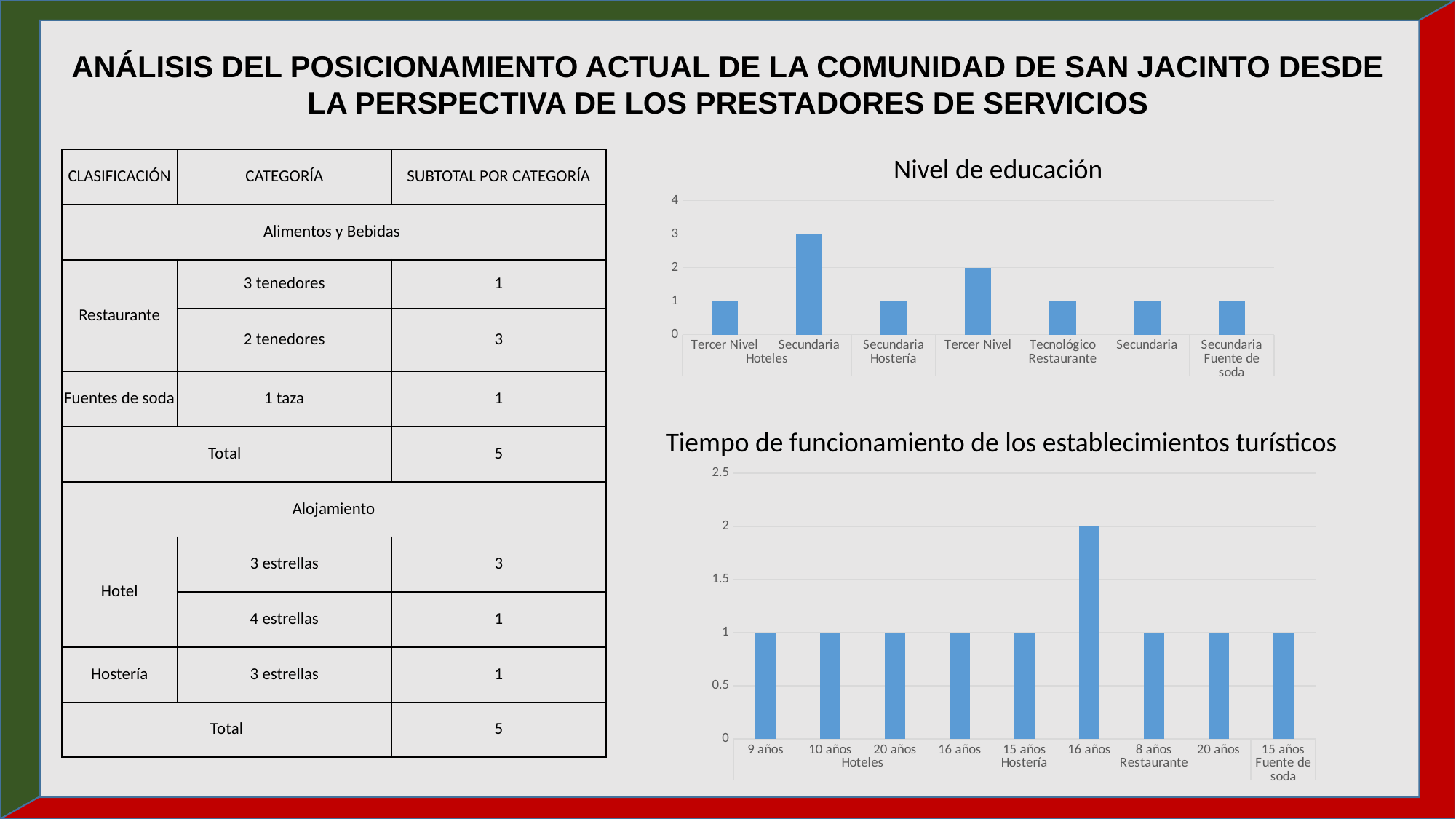
In the 'Nivel de educación' chart, which is larger: Secundaria under Hoteles or Secundaria under Hostería? Secundaria under Hoteles What kind of chart is 'Tiempo de funcionamiento de los establecimientos turísticos'? Bar chart In the 'Tiempo de funcionamiento de los establecimientos turísticos' chart, what is the value for 8 años under Restaurante? 1 In the 'Nivel de educación' chart, how many bars are plotted? 7 In the 'Nivel de educación' chart, what is the difference between Secundaria under Hoteles and Tercer Nivel under Restaurante? 1 In the 'Tiempo de funcionamiento de los establecimientos turísticos' chart, how many bars are plotted? 9 In the 'Nivel de educación' chart, what is the value for Secundaria under Hoteles? 3 In the 'Nivel de educación' chart, what is the value for Tercer Nivel under Restaurante? 2 In the 'Tiempo de funcionamiento de los establecimientos turísticos' chart, which category has the highest value? 16 años (Restaurante) In the 'Nivel de educación' chart, which category has the highest value? Secundaria (Hoteles) What is the title of the upper chart on the slide? Nivel de educación